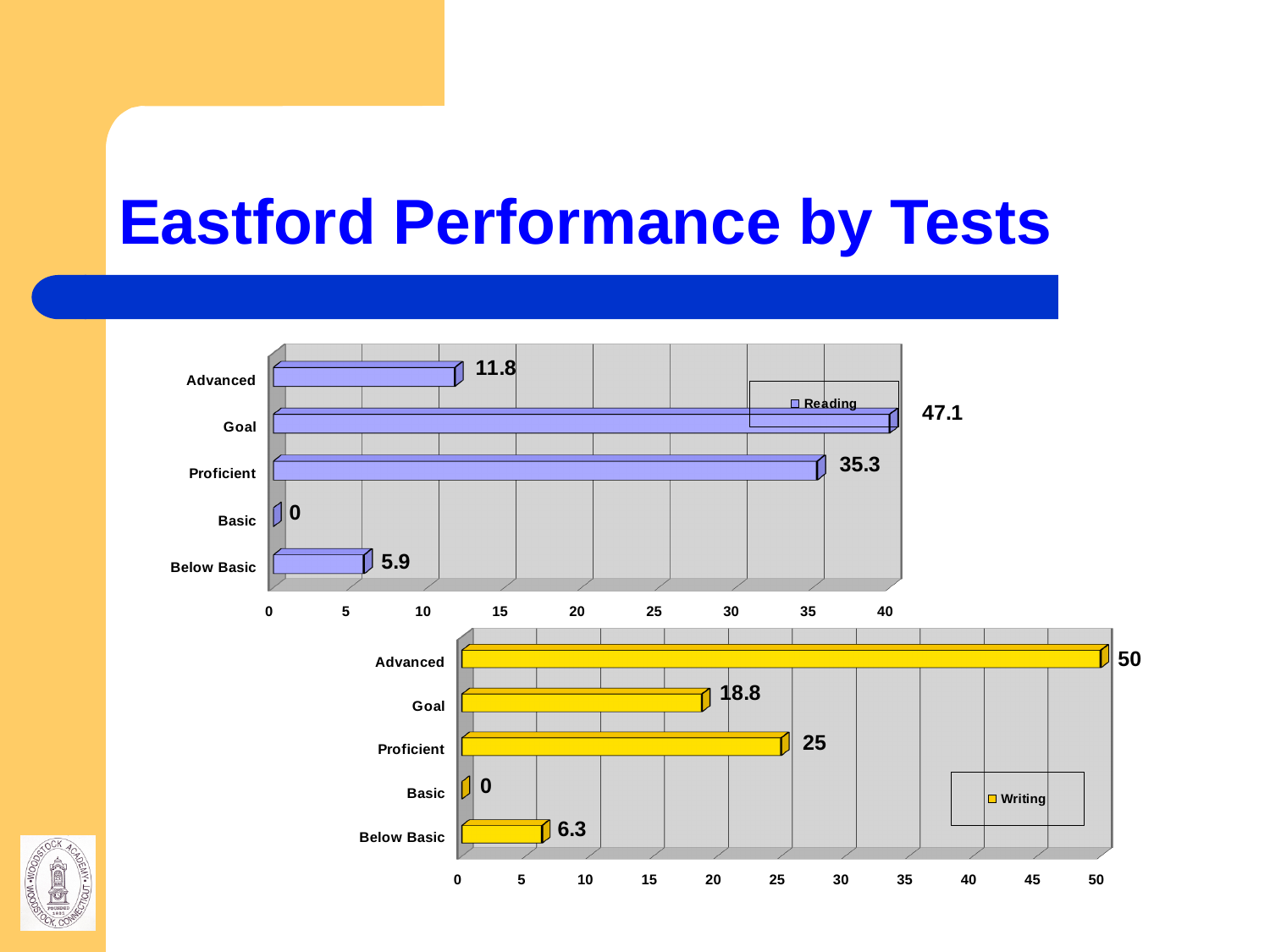
What kind of chart is the Writing chart? Bar chart In the Writing chart, which category has the lowest value? Basic In the Reading chart, what is the value for Goal? 47.1 In the Reading chart, which category has the highest value? Goal How many categories does the Reading chart show? 5 In the Writing chart, what is the difference between the Proficient and Goal values? 6.2 In the Reading chart, what is the value for Below Basic? 5.9 In the Reading chart, what is the difference between the Goal and Proficient values? 11.8 In the Writing chart, what is the value for Goal? 18.8 What series name does the legend of the top chart show? Reading In the Writing chart, what is the value for Advanced? 50 In the Writing chart, which is larger, the value for Proficient or the value for Goal? Proficient